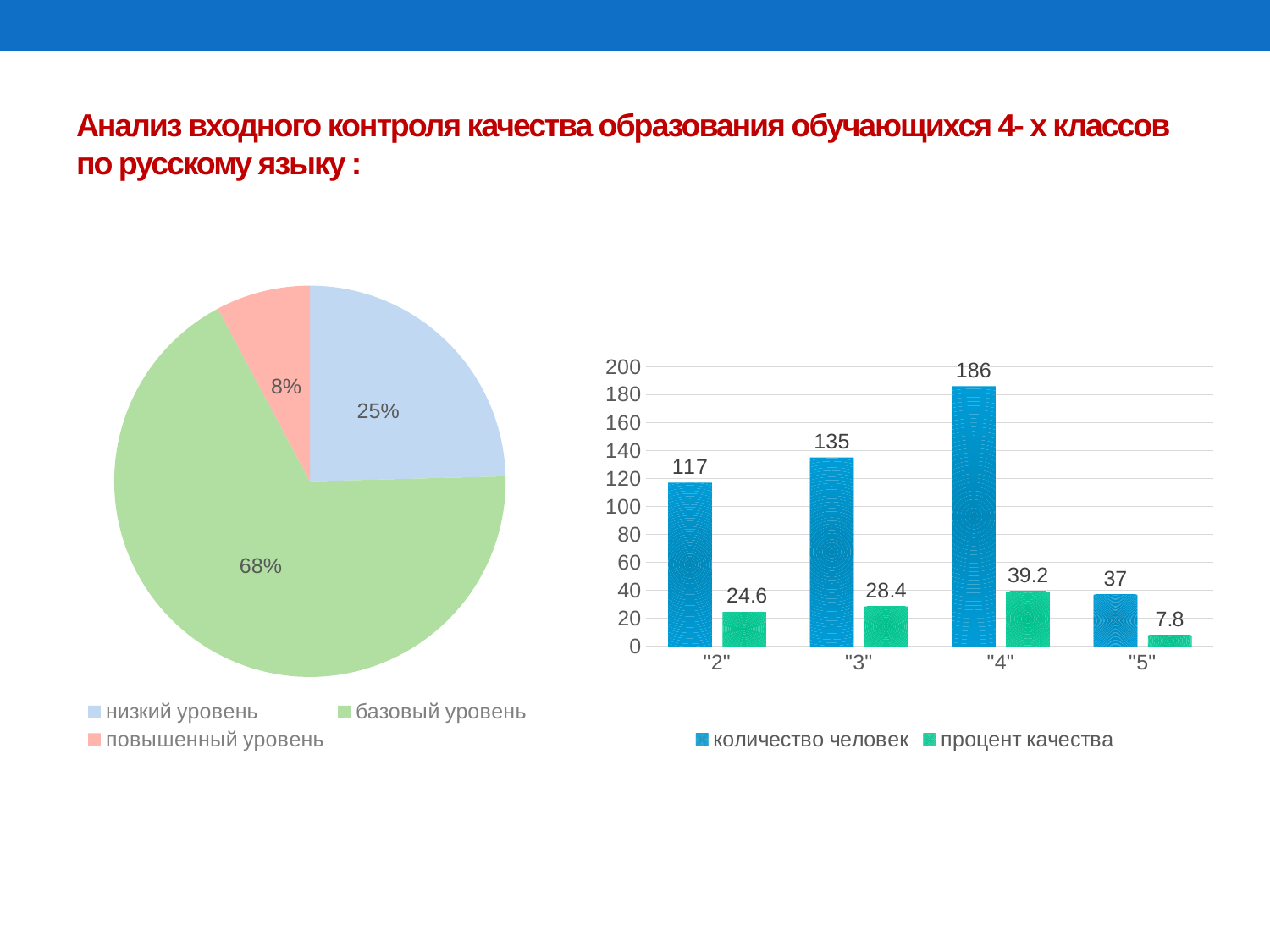
In the bar chart on the right, what is the value of 'количество человек' for "4"? 186 In the pie chart on the left, which level has the smallest share? повышенный уровень What type of chart is shown on the right side of the slide? bar chart In the bar chart on the right, what is the difference in 'количество человек' between "4" and "2"? 69 In the bar chart on the right, how many series does the legend list? 2 In the pie chart on the left, what share does 'низкий уровень' have? 25% In the pie chart on the left, how many slices are there? 3 In the pie chart on the left, what share does 'базовый уровень' have? 68% In the bar chart on the right, which category has the highest 'процент качества'? "4" In the bar chart on the right, which category has the lowest 'количество человек'? "5" In the bar chart on the right, is 'количество человек' larger for "3" or for "5"? "3" In the bar chart on the right, what is the value of 'процент качества' for "3"? 28.4